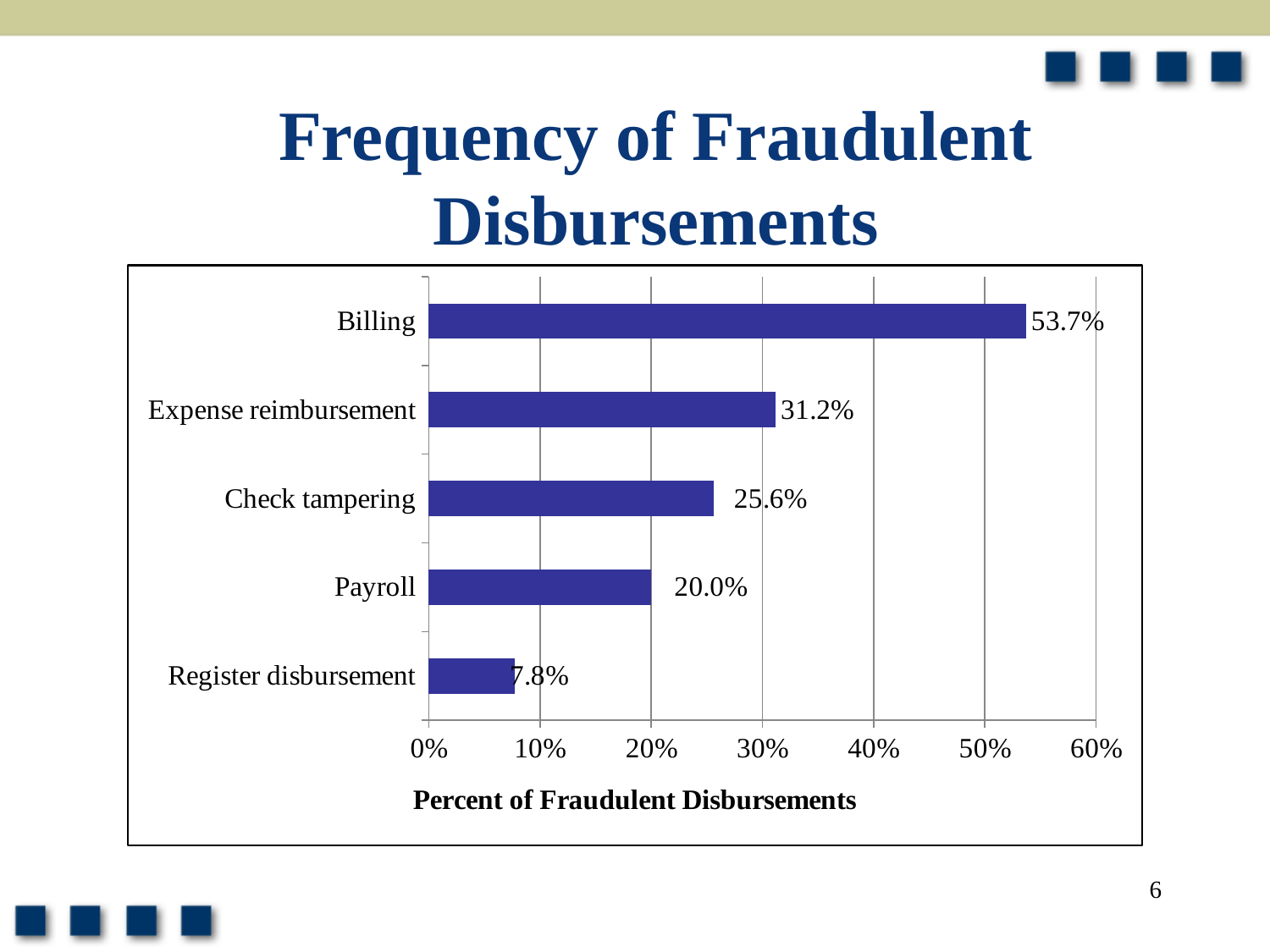
What is the value for Register disbursement? 7.8% What kind of chart is shown on the slide? Bar chart Which category has the highest percent of fraudulent disbursements? Billing What is the label of the horizontal axis? Percent of Fraudulent Disbursements What is the value for Billing? 53.7% How many categories are shown in the chart? 5 What is the value for Check tampering? 25.6% Which category has the lowest percent of fraudulent disbursements? Register disbursement What is the difference between the values for Billing and Expense reimbursement? 22.5% Which is larger, the value for Check tampering or the value for Payroll? Check tampering What is the value for Expense reimbursement? 31.2% What is the difference between the values for Payroll and Register disbursement? 12.2%